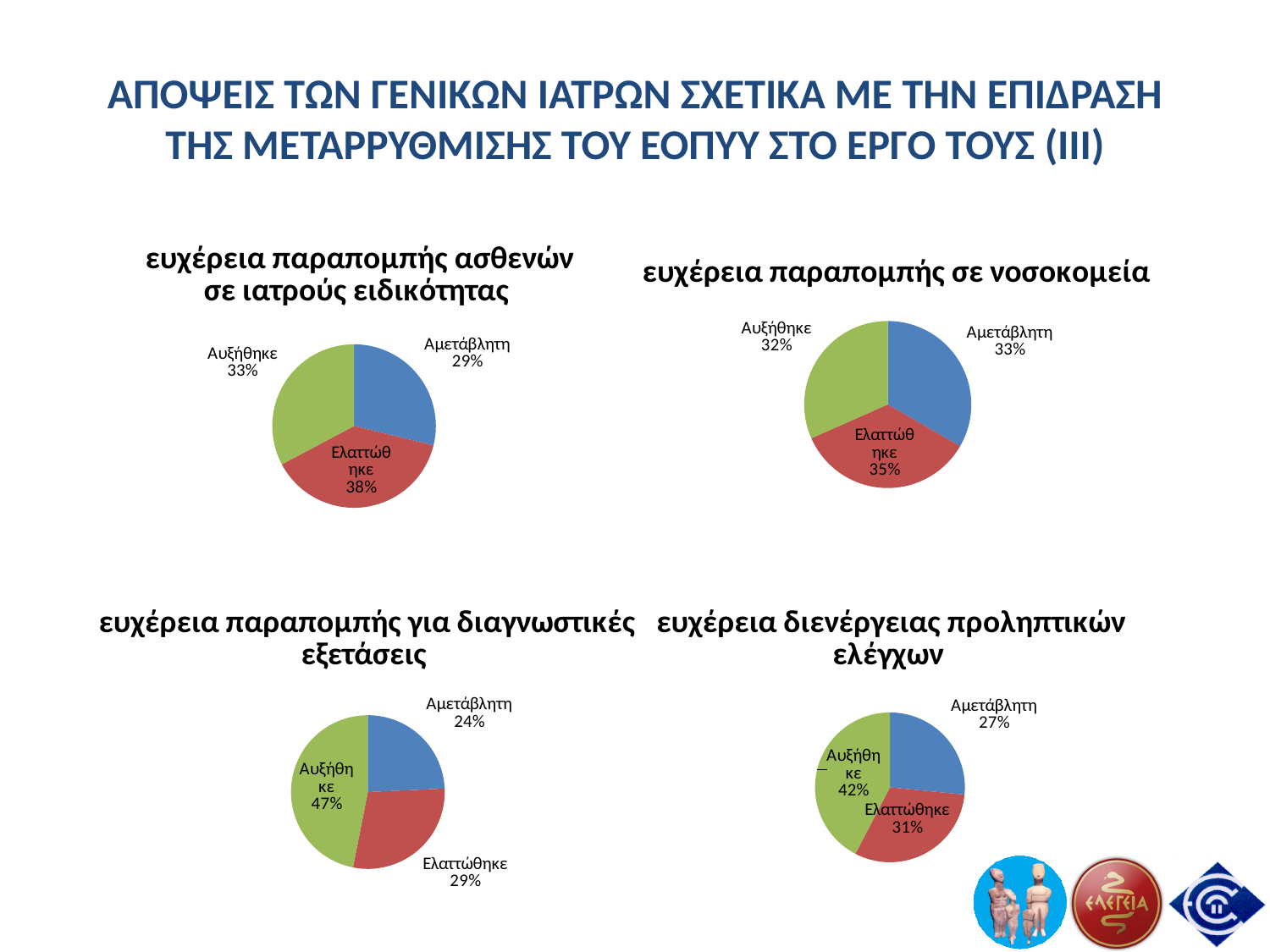
How many pie charts are shown on the slide? 4 In the chart titled 'ευχέρεια διενέργειας προληπτικών ελέγχων', which is larger, 'Αυξήθηκε' or 'Αμετάβλητη'? Αυξήθηκε In the chart titled 'ευχέρεια διενέργειας προληπτικών ελέγχων', what share does 'Ελαττώθηκε' have? 31% How many slices does the chart titled 'ευχέρεια παραπομπής σε νοσοκομεία' have? 3 In the chart titled 'ευχέρεια παραπομπής για διαγνωστικές εξετάσεις', what is the difference between the 'Αυξήθηκε' and 'Αμετάβλητη' shares? 23% In the chart titled 'ευχέρεια παραπομπής ασθενών σε ιατρούς ειδικότητας', which category has the smallest share? Αμετάβλητη In the chart titled 'ευχέρεια παραπομπής για διαγνωστικές εξετάσεις', what share does 'Αυξήθηκε' have? 47% In the chart titled 'ευχέρεια παραπομπής σε νοσοκομεία', which category has the largest share? Ελαττώθηκε In the chart titled 'ευχέρεια διενέργειας προληπτικών ελέγχων', what is the difference between the 'Αυξήθηκε' and 'Ελαττώθηκε' shares? 11% In the chart titled 'ευχέρεια παραπομπής σε νοσοκομεία', what share does 'Αυξήθηκε' have? 32% What kind of chart is the chart titled 'ευχέρεια παραπομπής ασθενών σε ιατρούς ειδικότητας'? Pie chart In the chart titled 'ευχέρεια παραπομπής ασθενών σε ιατρούς ειδικότητας', what share does 'Ελαττώθηκε' have? 38%